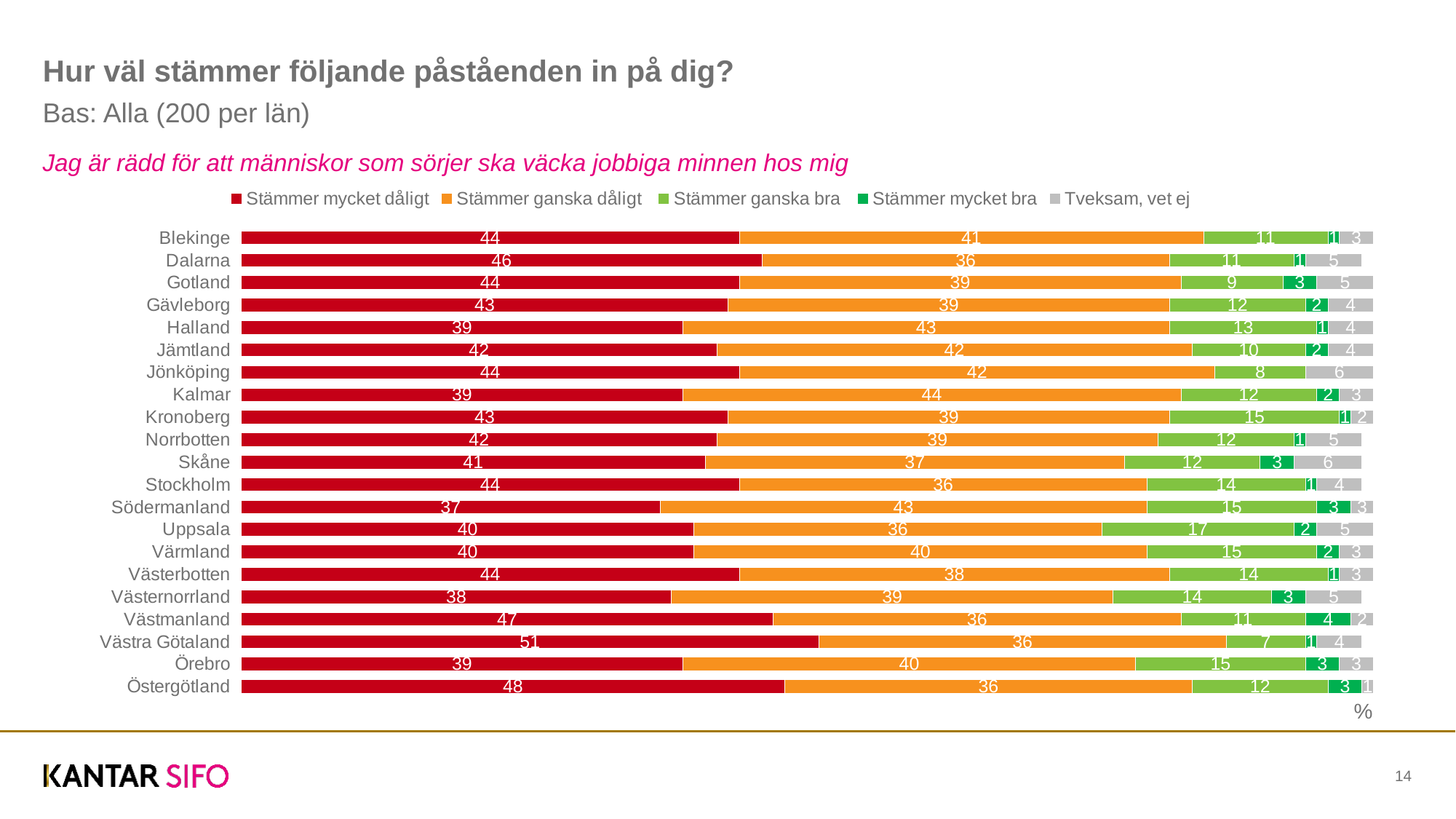
Which county has the lowest value for "Stämmer mycket dåligt"? Södermanland What percentage of respondents in Västra Götaland answered "Stämmer mycket dåligt"? 51 Which series is shown in red in the chart? Stämmer mycket dåligt What is the "Tveksam, vet ej" value for Jönköping? 6 Which county has the lowest value for "Stämmer ganska bra"? Västra Götaland How many series does the legend list? 5 How many counties are shown in the chart? 21 What is the difference between the "Stämmer mycket dåligt" values for Östergötland and Halland? 9 Which county has the highest value for "Stämmer mycket dåligt"? Västra Götaland Which is larger: the "Stämmer ganska dåligt" value for Kalmar or for Stockholm? Kalmar What is the value for "Stämmer ganska bra" in Uppsala? 17 What type of chart is shown on the slide? Stacked bar chart